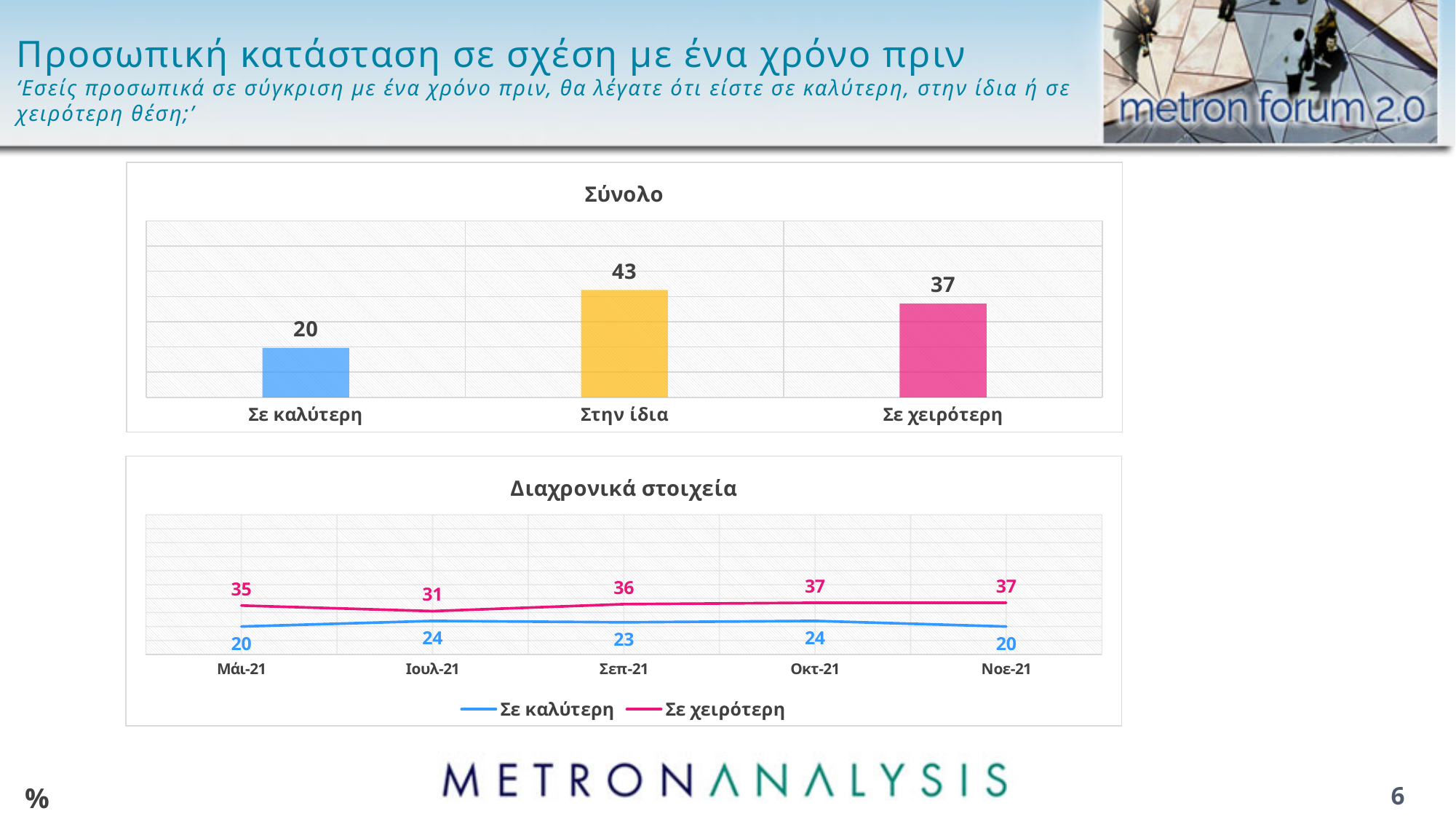
In the 'Σύνολο' chart, what is the difference between 'Στην ίδια' and 'Σε χειρότερη'? 6 What kind of chart is the 'Σύνολο' chart? bar chart In the 'Σύνολο' chart, which category has the highest value? Στην ίδια In the 'Διαχρονικά στοιχεία' chart, what is the value for 'Σε χειρότερη' in Ιουλ-21? 31 In the 'Διαχρονικά στοιχεία' chart, which is larger in Οκτ-21: 'Σε καλύτερη' or 'Σε χειρότερη'? Σε χειρότερη In the 'Διαχρονικά στοιχεία' chart, what is the value for 'Σε καλύτερη' in Σεπ-21? 23 In the 'Σύνολο' chart, which category has the lowest value? Σε καλύτερη In the 'Διαχρονικά στοιχεία' chart, how many time points are plotted on the x axis? 5 In the 'Σύνολο' chart, what is the value for 'Στην ίδια'? 43 In the 'Διαχρονικά στοιχεία' chart, what is the difference between 'Σε χειρότερη' and 'Σε καλύτερη' in Νοε-21? 17 In the 'Διαχρονικά στοιχεία' chart, how many series does the legend list? 2 In the 'Σύνολο' chart, how many categories are shown? 3